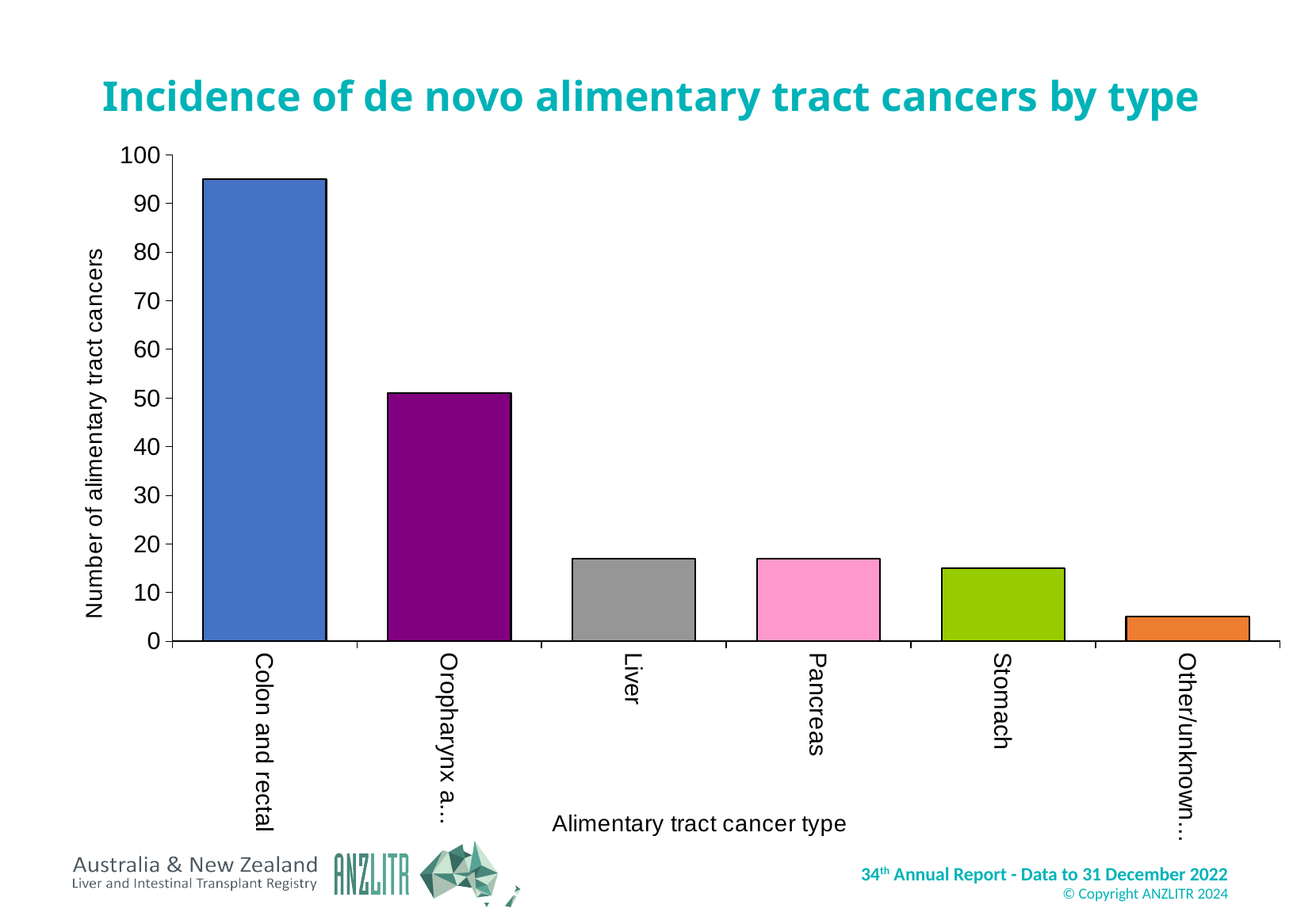
Is the value for Oropharynx greater or less than 60? less What is the label of the y axis? Number of alimentary tract cancers Which cancer type has the highest number of alimentary tract cancers? Colon and rectal Which is larger, the value for Colon and rectal or the value for Oropharynx? Colon and rectal Which cancer type has the lowest number of alimentary tract cancers? Other/unknown How many cancer type categories are plotted on the chart? 6 What kind of chart is shown on the slide? bar chart Is the value for Other/unknown greater or less than 10? less Is the value for Stomach greater or less than 10? greater Do the bar values generally rise or fall moving from left to right along the x axis? fall